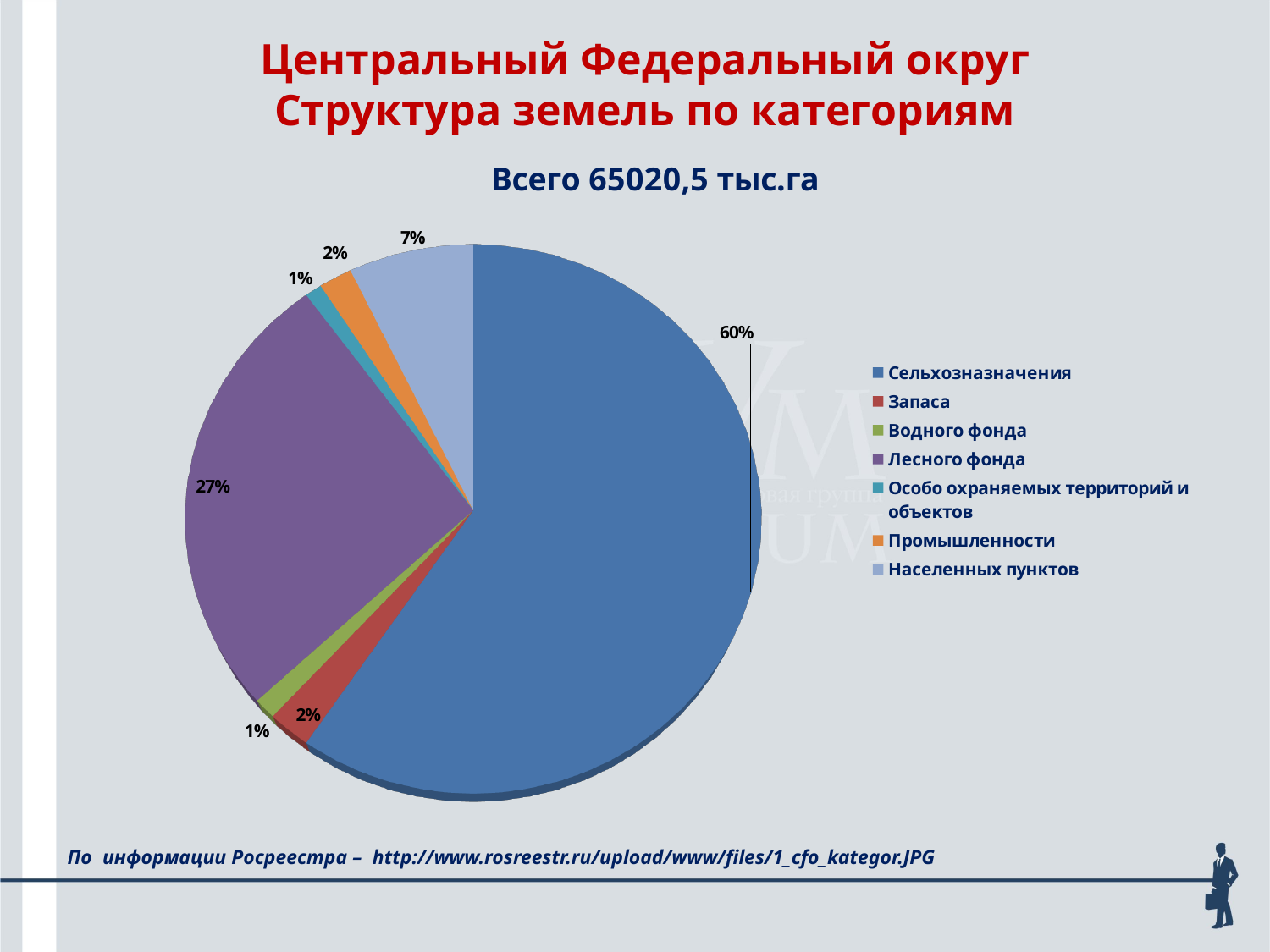
What share of the pie does Сельхозназначения take? 60% What kind of chart is shown on the slide? pie chart What share of the pie does Запаса take? 2% What share of the pie does Водного фонда take? 1% Which category has the largest share of the pie? Сельхозназначения What total is stated in the chart title above the pie? Всего 65020,5 тыс.га Which is larger, the share for Лесного фонда or the share for Населенных пунктов? Лесного фонда By how many percentage points does the share for Сельхозназначения exceed the share for Лесного фонда? 33 percentage points How many categories does the legend of the pie chart list? 7